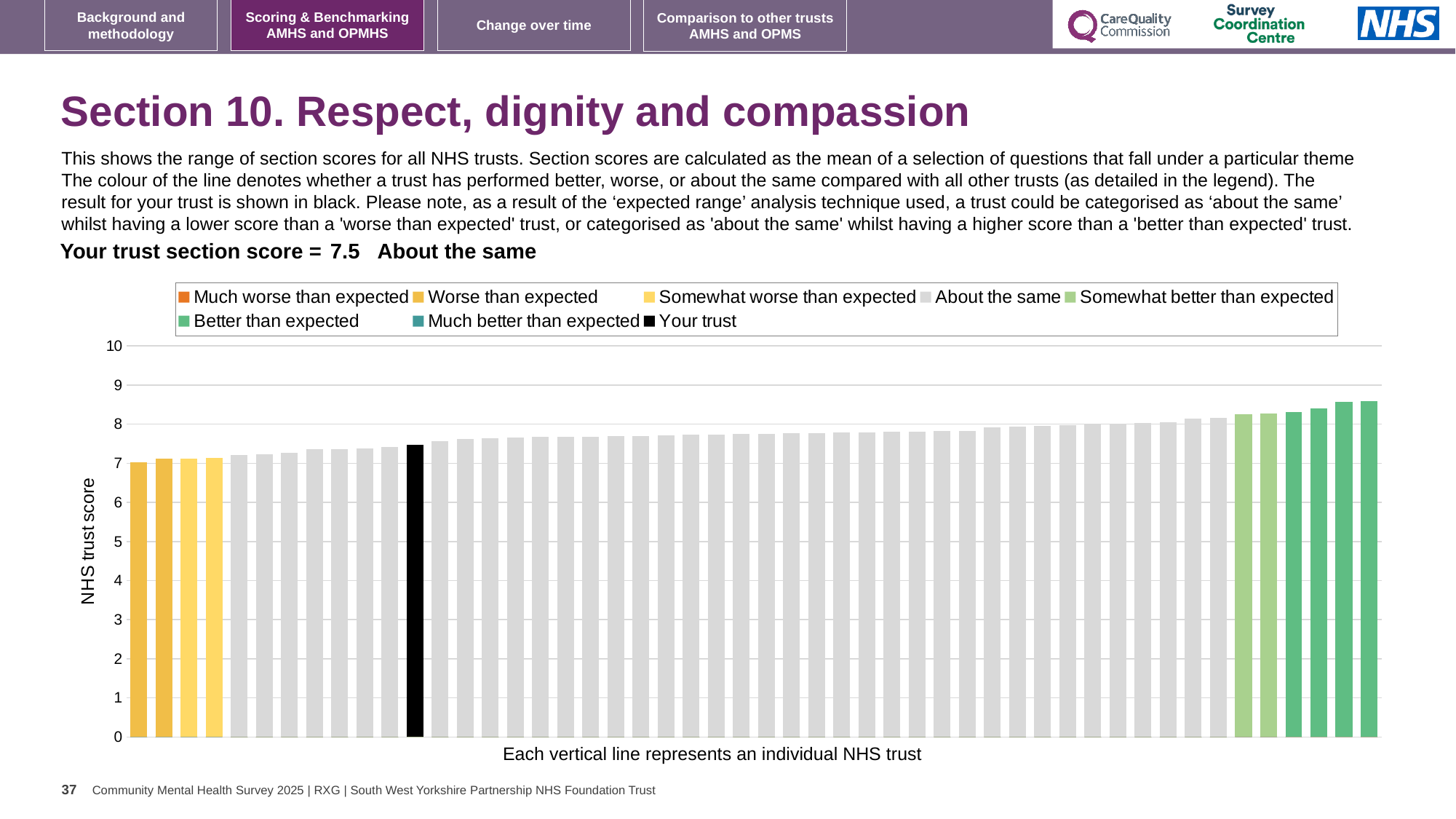
What is the label of the vertical axis? NHS trust score What is the highest value shown on the vertical axis? 10 How is your trust's section score categorised compared with other trusts? About the same Do the bar values rise or fall from left to right along the x axis? Rise What is the section score for your trust shown on the slide? 7.5 What kind of chart is shown on the slide? Bar chart Is the value for your trust (the black bar) greater or less than 7? greater Is the value of the shortest bar in the chart greater or less than 6? greater What colour is used for the bar representing your trust? Black Is the value of the tallest bar in the chart greater or less than 8? greater How many entries does the chart legend list? 8